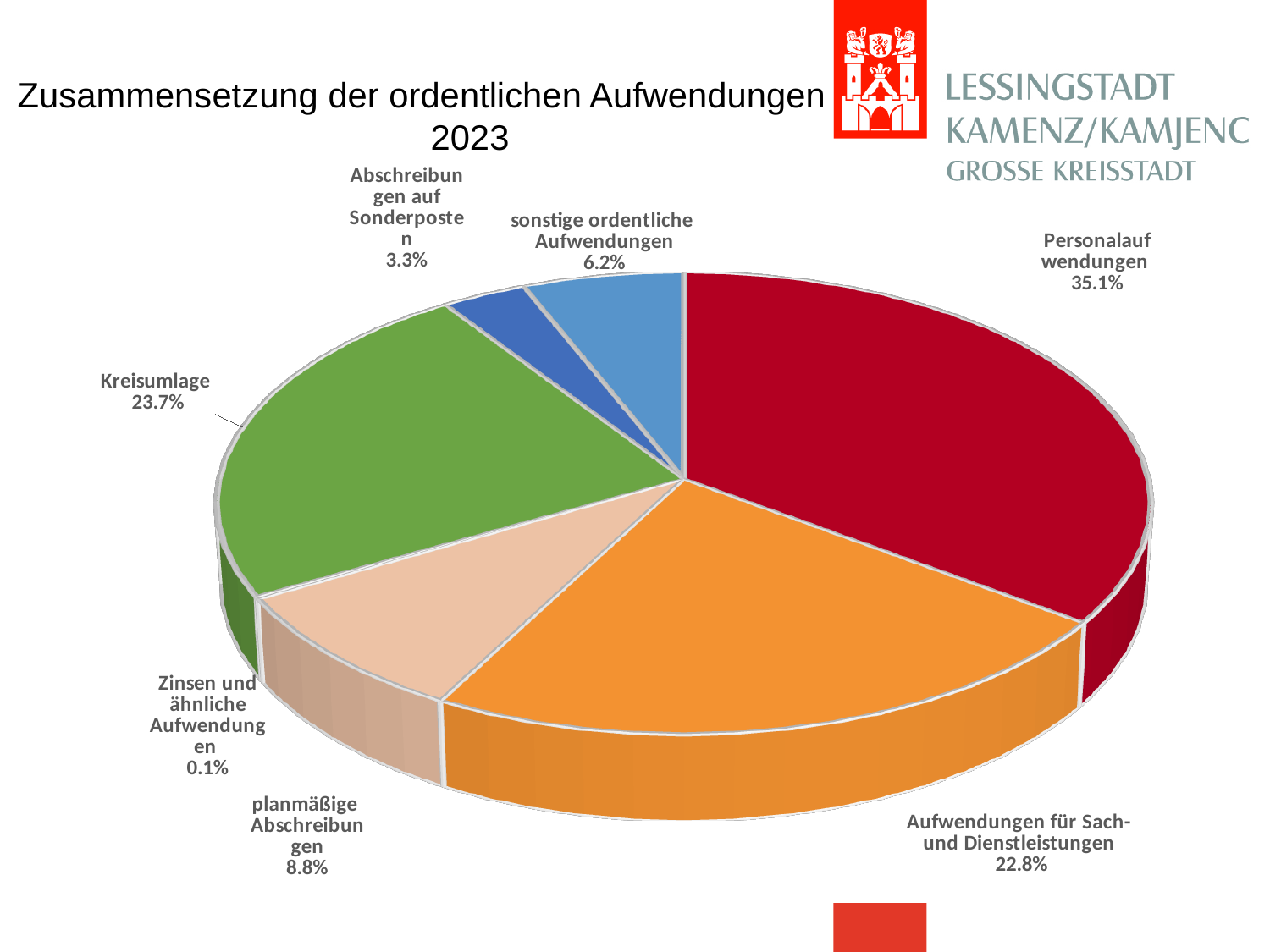
Which is larger: sonstige ordentliche Aufwendungen or Abschreibungen auf Sonderposten? sonstige ordentliche Aufwendungen What percentage is shown for Kreisumlage? 23.7% What percentage is shown for planmäßige Abschreibungen? 8.8% What type of chart is shown on the slide? Pie chart What share is shown for Aufwendungen für Sach- und Dienstleistungen? 22.8% What is the title of the chart? Zusammensetzung der ordentlichen Aufwendungen 2023 Which category has the largest share of the pie? Personalaufwendungen What share is shown for Zinsen und ähnliche Aufwendungen? 0.1% What is the difference in percentage points between Personalaufwendungen and Kreisumlage? 11.4 How many slices does the pie chart have? 7 What share of the ordinary expenses is Personalaufwendungen? 35.1% Which category has the smallest share of the pie? Zinsen und ähnliche Aufwendungen